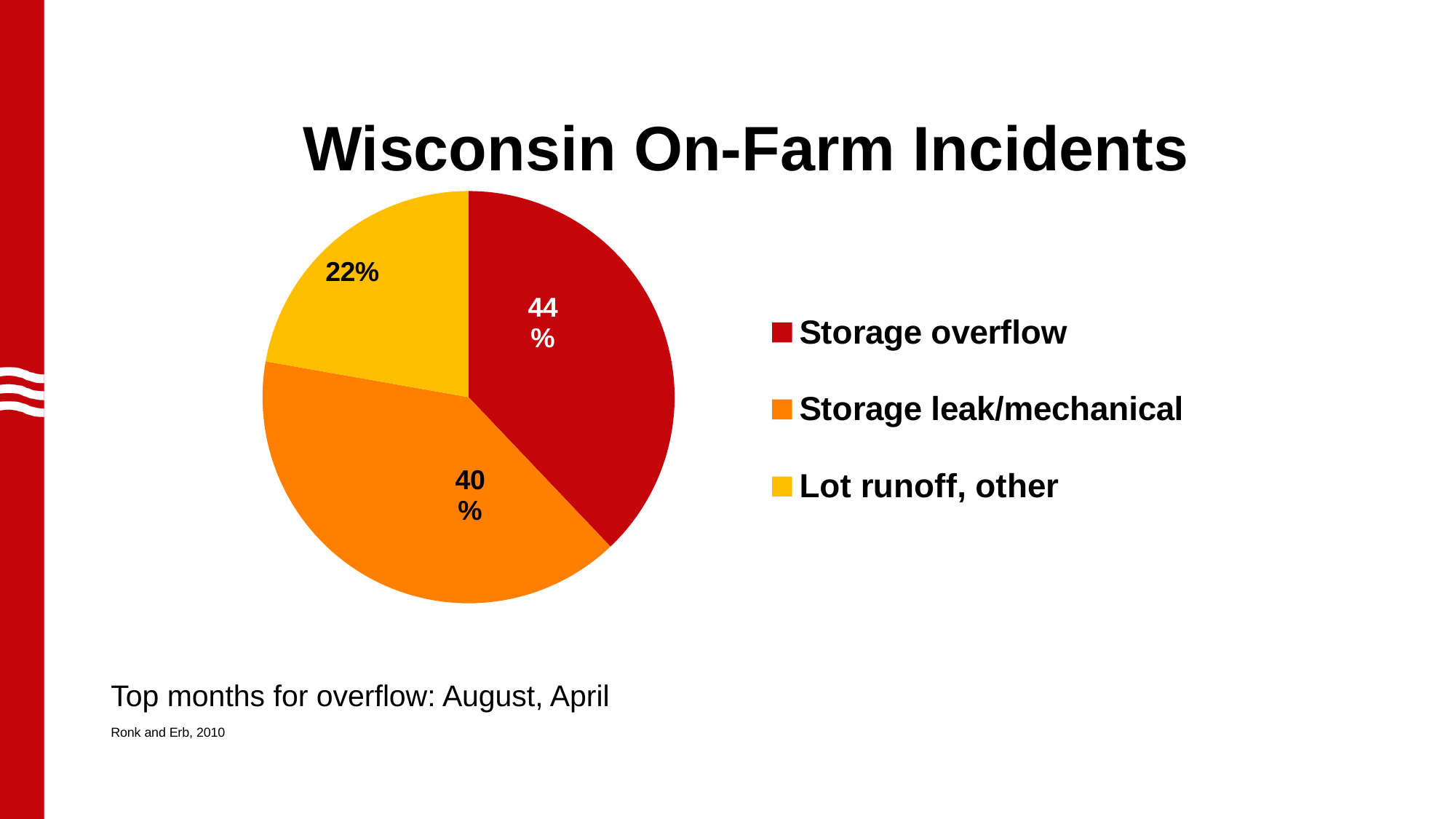
How many percentage points larger is the storage overflow share than the lot runoff, other share? 22 Which colour represents storage leak/mechanical in the pie chart? Orange How many categories does the pie chart show? 3 What is the title of the chart? Wisconsin On-Farm Incidents What is the difference in percentage points between storage overflow and storage leak/mechanical? 4 What percentage of incidents is due to storage leak/mechanical causes? 40% What percentage of incidents falls under lot runoff, other? 22% Which category accounts for the smallest share of incidents? Lot runoff, other Which is larger: the share for storage leak/mechanical or the share for lot runoff, other? Storage leak/mechanical What kind of chart is shown on the slide? Pie chart Which category accounts for the largest share of incidents? Storage overflow What share of Wisconsin on-farm incidents is attributed to storage overflow? 44%